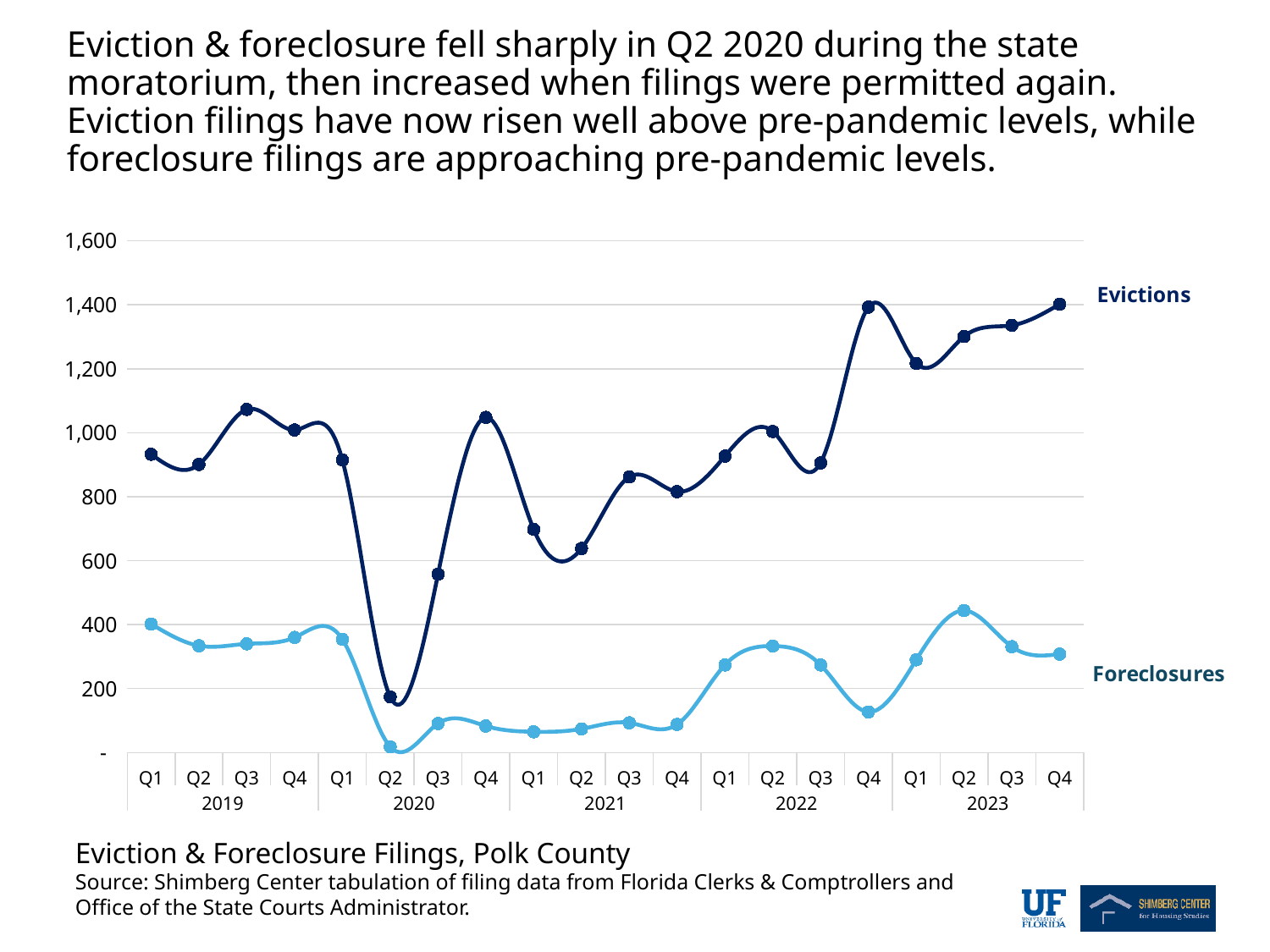
Is the value for Evictions in Q4 2022 greater or less than 1,200? greater Do Evictions rise or fall from Q1 2023 to Q4 2023? rise What is the title of the chart? Eviction & Foreclosure Filings, Polk County How many quarterly data points does each line have? 20 In which quarter is the Evictions line at its lowest? Q2 2020 What kind of chart is shown on the slide? line chart In which quarter is the Foreclosures line at its lowest? Q2 2020 Is the value for Foreclosures in Q2 2023 greater or less than 400? greater How many series are plotted on the chart? 2 In which quarter is the Foreclosures line at its highest? Q2 2023 Which is larger in Q1 2021: Evictions or Foreclosures? Evictions Is the value for Evictions in Q2 2020 greater or less than 200? less